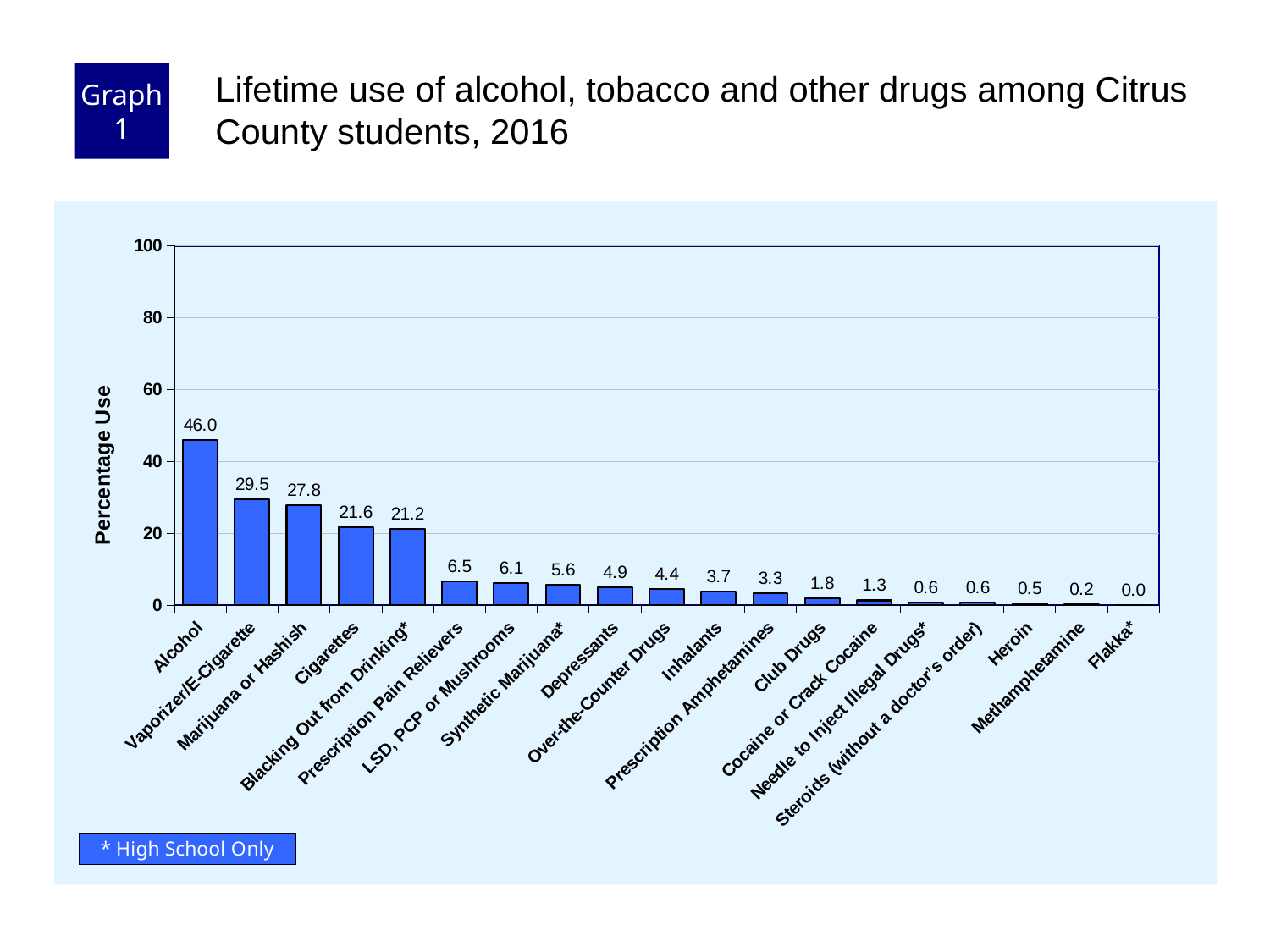
What is the lifetime use percentage for Alcohol? 46.0 What is the value shown for Cigarettes? 21.6 Which category has the lowest lifetime use? Flakka* How many categories are shown on the x axis? 19 Is the value for Prescription Pain Relievers greater or less than 20? less What is the difference between the values for Cigarettes and Blacking Out from Drinking*? 0.4 What is the label of the y axis? Percentage Use What is the difference between the values for Alcohol and Vaporizer/E-Cigarette? 16.5 Which category has the highest lifetime use? Alcohol What is the value shown for Inhalants? 3.7 Which is larger, the value for Marijuana or Hashish or the value for Cigarettes? Marijuana or Hashish What kind of chart is shown on the slide? bar chart